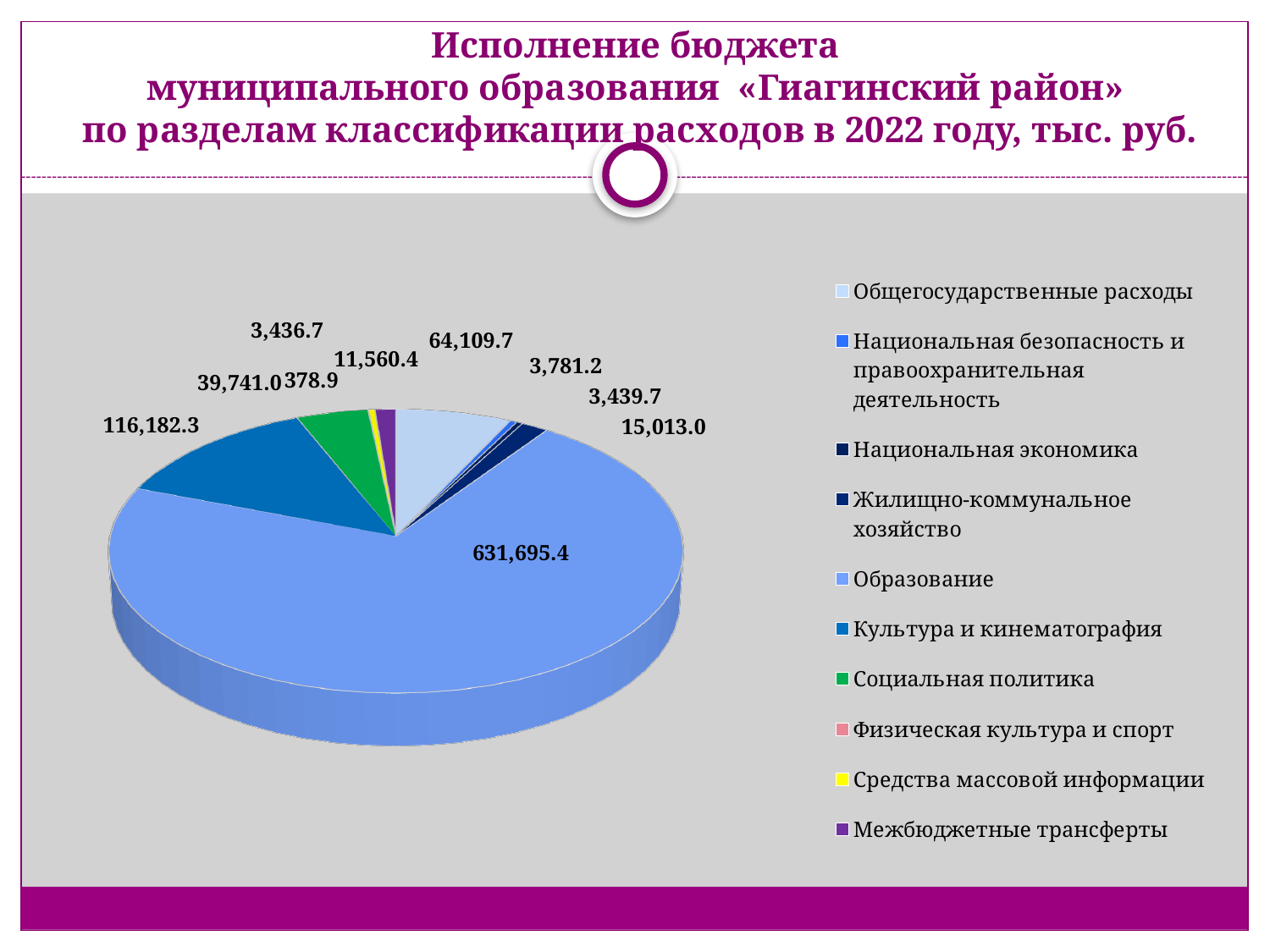
What is the value for Образование? 631,695.4 How many categories does the legend of the pie chart list? 10 What is the value for Межбюджетные трансферты? 11,560.4 What is the difference between the values for Образование and Культура и кинематография? 515,513.1 What is the value for Общегосударственные расходы? 64,109.7 What kind of chart is shown on the slide? pie chart Which category has the smallest value in the pie chart? Физическая культура и спорт What is the value for Культура и кинематография? 116,182.3 Which category has the largest slice of the pie? Образование What is the value for Социальная политика? 39,741.0 Which is larger, Культура и кинематография or Социальная политика? Культура и кинематография What is the value for Жилищно-коммунальное хозяйство? 15,013.0